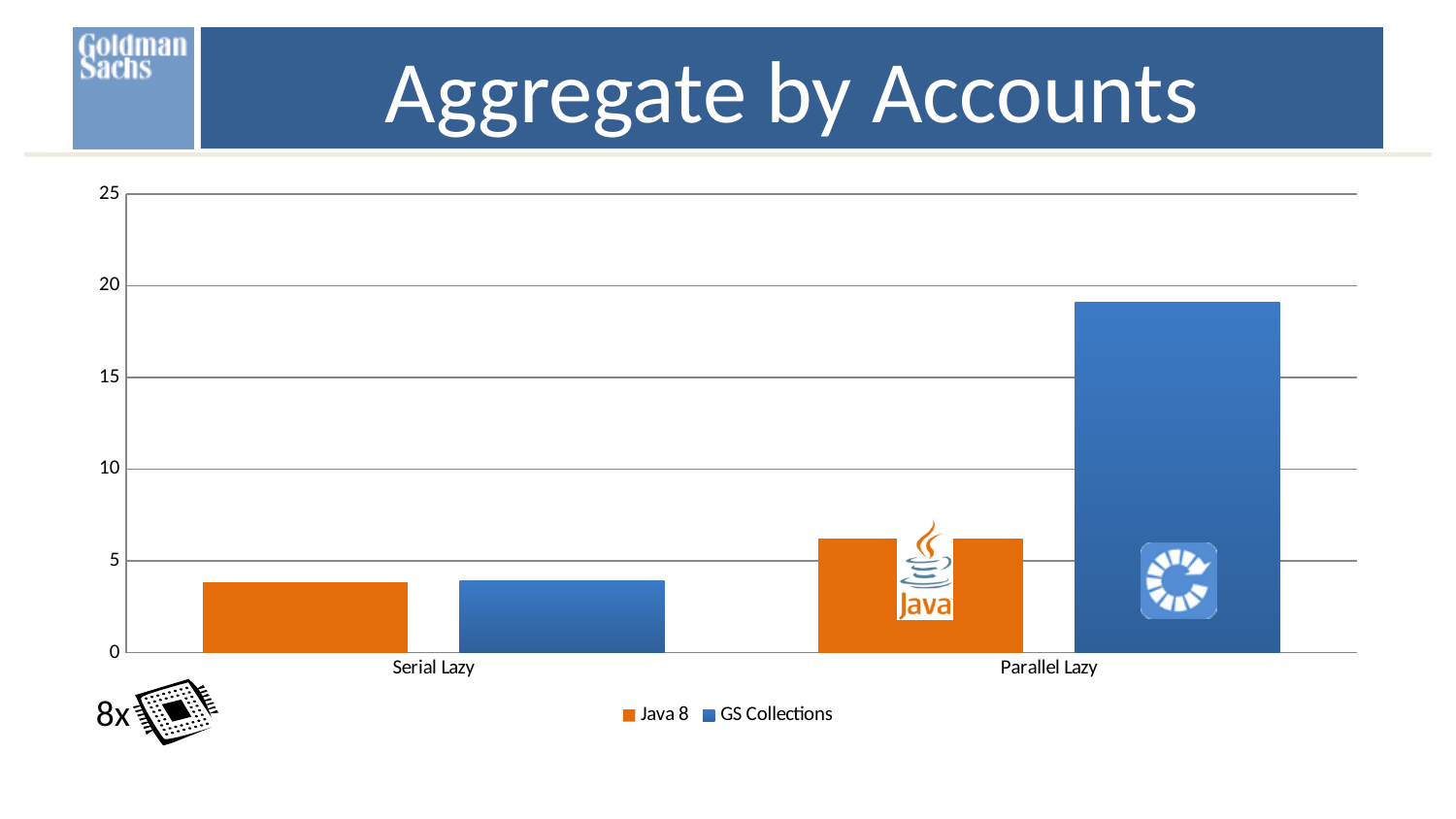
Is the GS Collections value for Parallel Lazy greater or less than 15? greater For Parallel Lazy, which series has the larger value, Java 8 or GS Collections? GS Collections Which series is shown in orange? Java 8 Is the Java 8 value for Serial Lazy greater or less than 5? less For Java 8, which category has the larger value, Serial Lazy or Parallel Lazy? Parallel Lazy Is the Java 8 value for Parallel Lazy greater or less than 5? greater What is the title of the chart on the slide? Aggregate by Accounts How many series does the legend list? 2 Which category has the highest GS Collections bar? Parallel Lazy What kind of chart is shown on the slide? bar chart How many categories are shown on the x axis? 2 Do the GS Collections values rise or fall from Serial Lazy to Parallel Lazy? rise